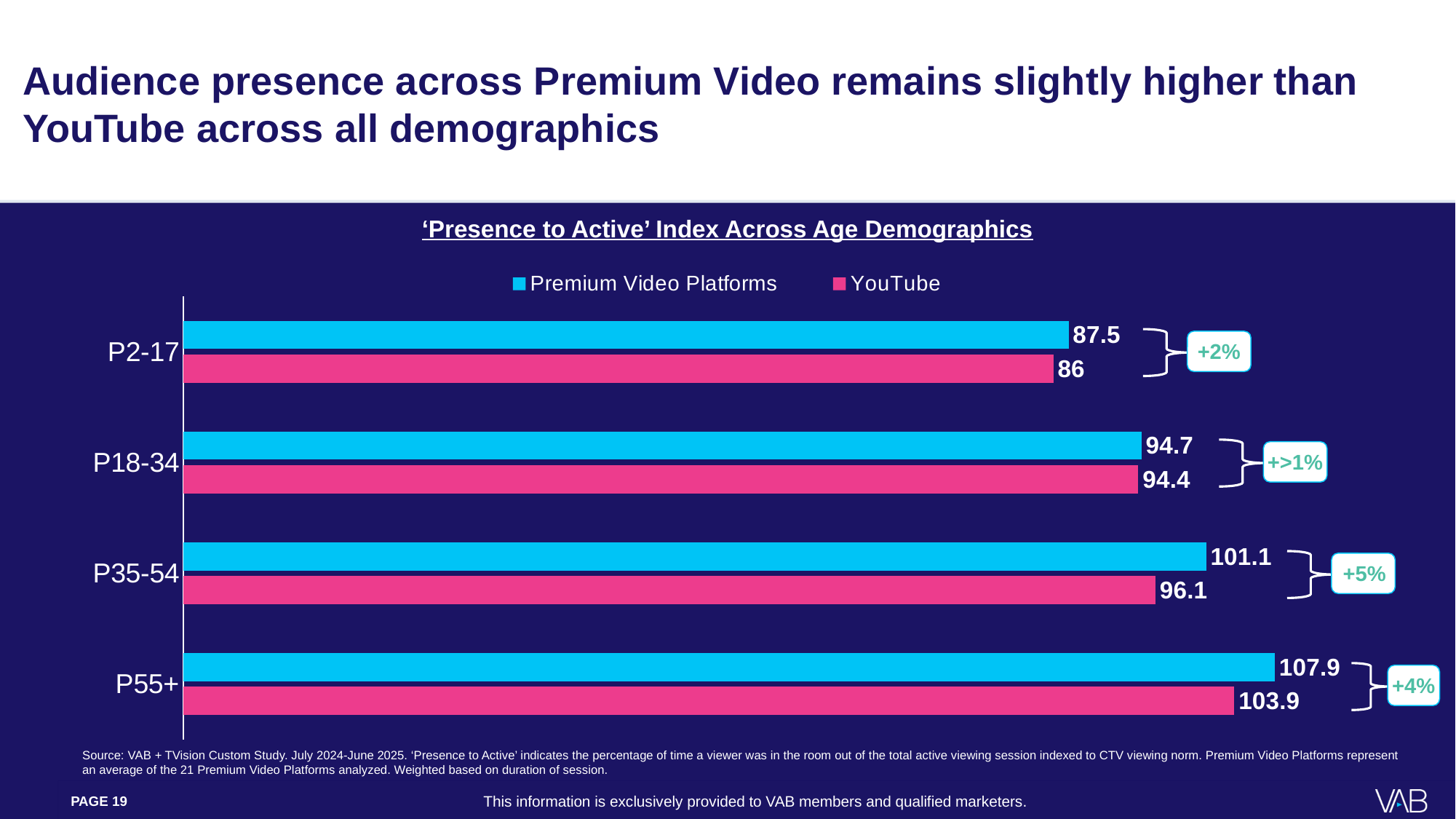
What is the YouTube value for P55+? 103.9 Which age demographic has the highest Premium Video Platforms value? P55+ What is the Premium Video Platforms value for P2-17? 87.5 What is the difference between the Premium Video Platforms value for P55+ and for P2-17? 20.4 What kind of chart is shown on the slide? Bar chart What is the difference between the Premium Video Platforms and YouTube values for P35-54? 5 What is the title of the chart? 'Presence to Active' Index Across Age Demographics Which is larger for P18-34: the Premium Video Platforms value or the YouTube value? Premium Video Platforms Which age demographic has the lowest YouTube value? P2-17 What is the YouTube value for P35-54? 96.1 How many age demographics are shown on the chart? 4 How many series does the legend list? 2